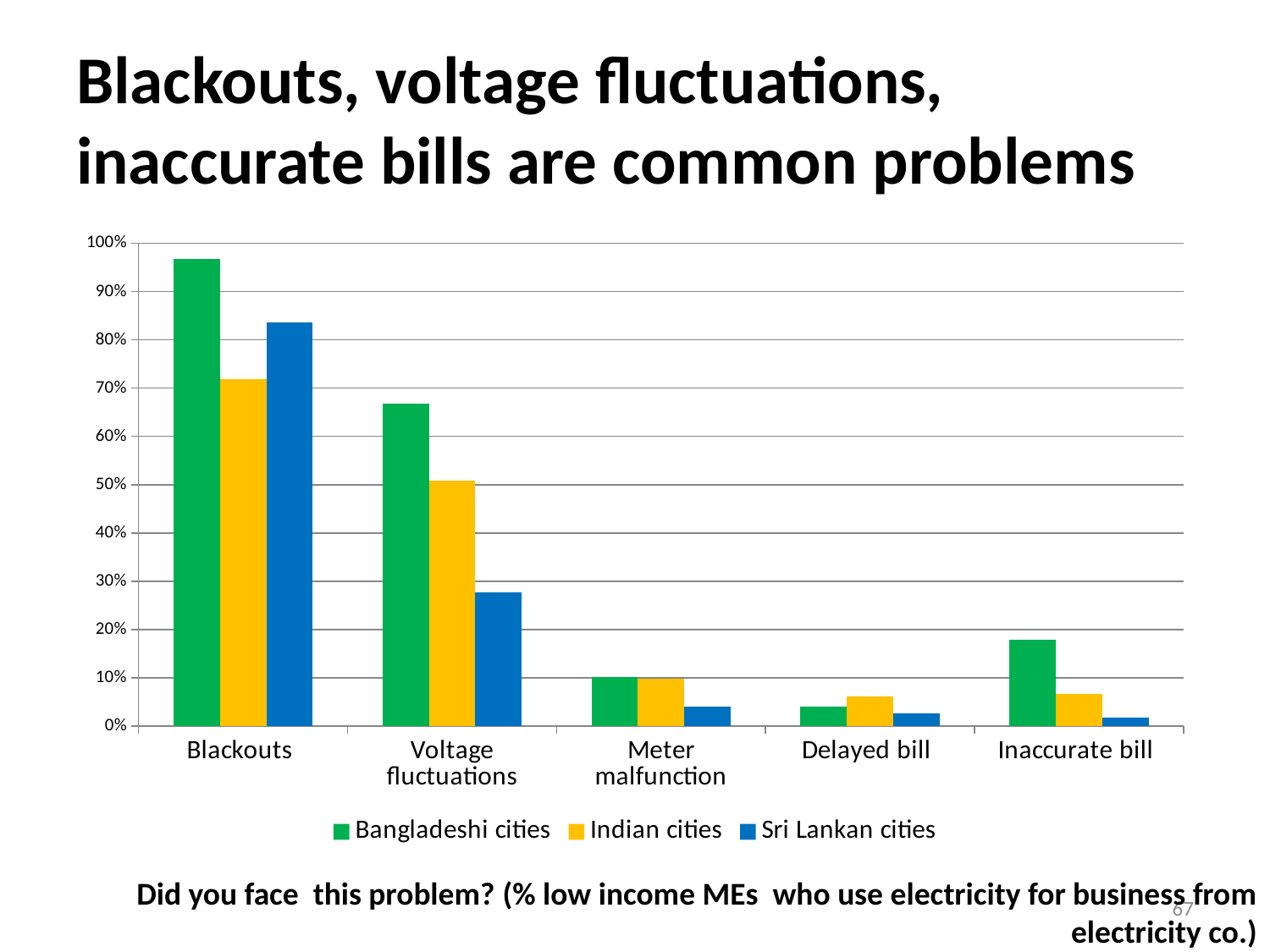
For Bangladeshi cities, which problem has the highest value? Blackouts For Voltage fluctuations, which is larger: the value for Bangladeshi cities or for Sri Lankan cities? Bangladeshi cities How many problem categories are shown on the x axis? 5 What kind of chart is shown on the slide? Bar chart Is the value for Indian cities for Voltage fluctuations greater or less than 60%? less For Blackouts, which is larger: the value for Indian cities or for Sri Lankan cities? Sri Lankan cities Which colour represents Sri Lankan cities in the legend? Blue Is the value for Bangladeshi cities for Blackouts greater or less than 90%? greater Is the value for Sri Lankan cities for Voltage fluctuations greater or less than 20%? greater How many series does the legend list? 3 For Bangladeshi cities, which problem has the lowest value? Delayed bill For Inaccurate bill, which series has the highest value? Bangladeshi cities